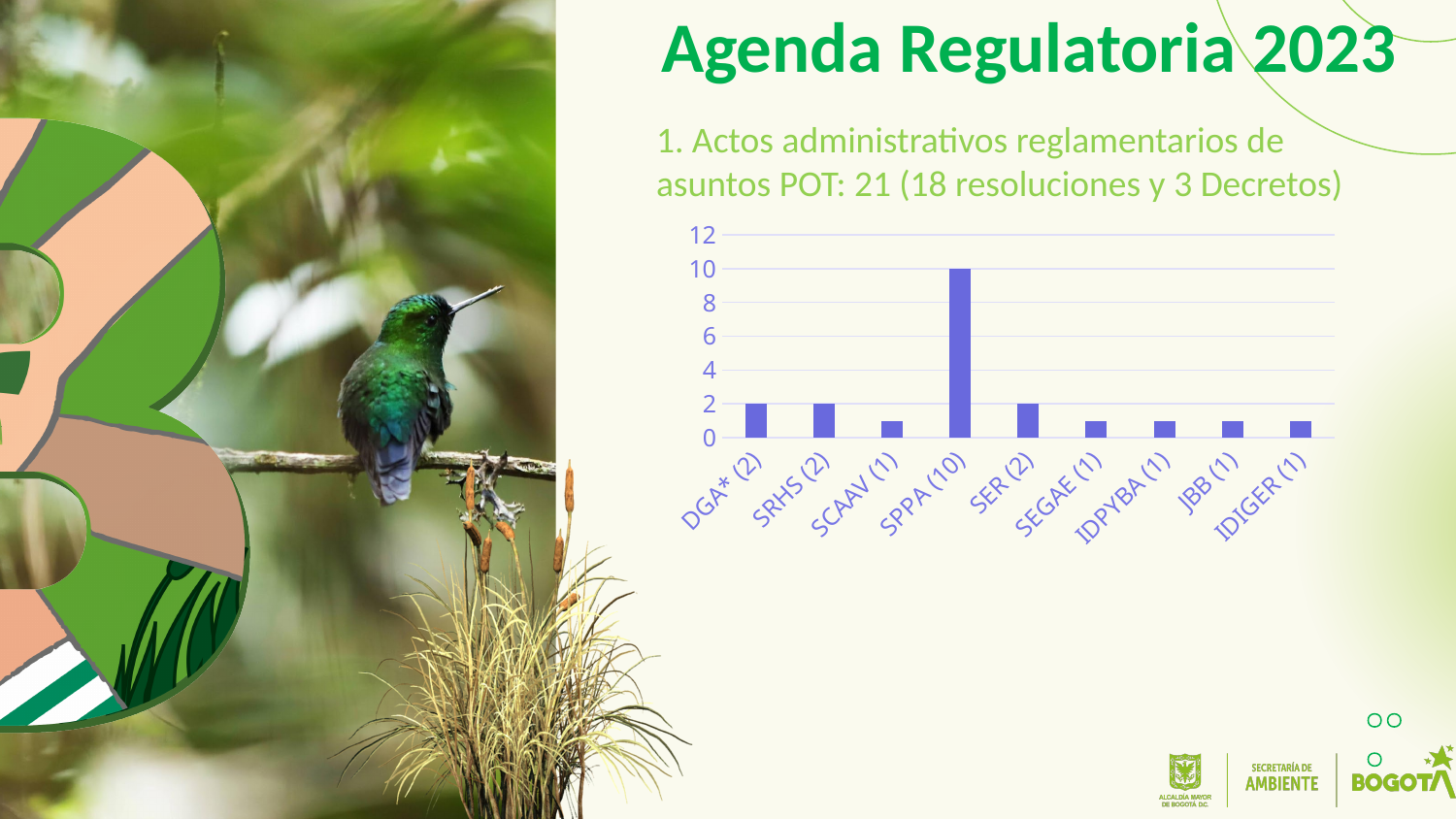
What is the difference between the values for SEGAE and JBB? 0 What is the highest tick value shown on the vertical axis of the chart? 12 Which category has the highest value in the chart? SPPA (10) What type of chart is shown on the slide? bar chart What is the difference between the values for SPPA and SER? 8 What is the value for DGA* in the chart? 2 How many categories in the chart have a value of 1? 5 What is the value for IDIGER in the chart? 1 What is the value for SPPA in the chart? 10 Which is larger, the value for SRHS or the value for SCAAV? SRHS How many categories are shown on the x axis of the chart? 9 Is the value for SPPA greater or less than 8? greater